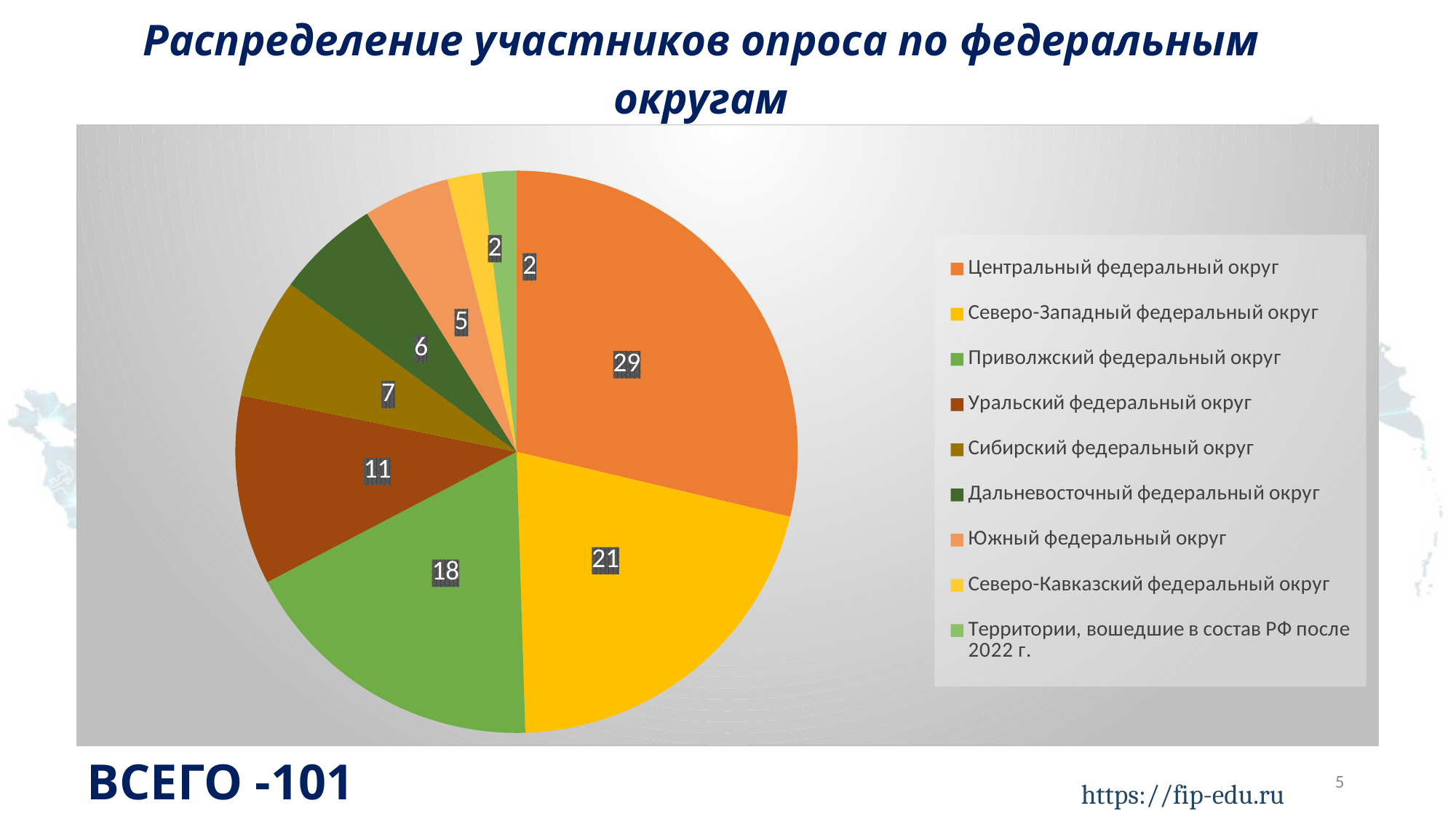
Which is larger: the value for Сибирский федеральный округ or Дальневосточный федеральный округ? Сибирский федеральный округ Which federal district has the largest share of survey participants? Центральный федеральный округ What is the difference between the values for Северо-Западный федеральный округ and Уральский федеральный округ? 10 What is the value for Северо-Западный федеральный округ? 21 What is the total number of survey participants shown on the slide? 101 What type of chart is shown on the slide? pie chart What is the value for Центральный федеральный округ? 29 What colour is the slice for Центральный федеральный округ? orange What is the difference between the values for Центральный федеральный округ and Приволжский федеральный округ? 11 What is the value for Южный федеральный округ? 5 What is the value for Уральский федеральный округ? 11 How many categories does the legend list? 9